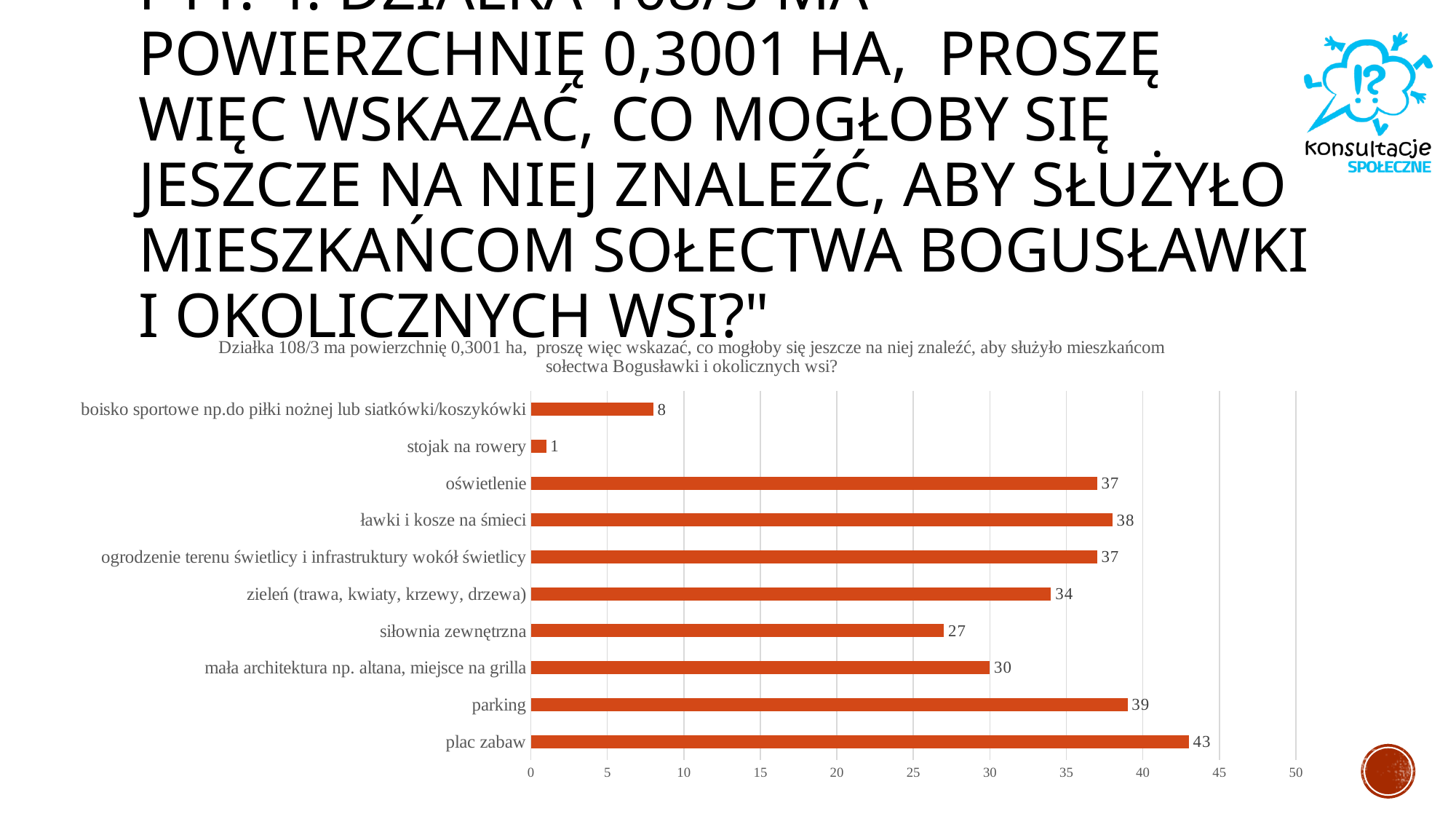
Which is larger, the value for "zieleń (trawa, kwiaty, krzewy, drzewa)" or the value for "siłownia zewnętrzna"? zieleń (trawa, kwiaty, krzewy, drzewa) Is the value for "ławki i kosze na śmieci" greater or less than 35? greater What is the value for "siłownia zewnętrzna"? 27 Which category has the lowest value? stojak na rowery How many categories are shown in the chart? 10 What is the value for "stojak na rowery"? 1 Which category has the highest value? plac zabaw What kind of chart is shown on the slide? bar chart What is the value for "boisko sportowe np.do piłki nożnej lub siatkówki/koszykówki"? 8 What is the difference between the values for "parking" and "mała architektura np. altana, miejsce na grilla"? 9 What is the highest value shown on the x axis? 50 What is the value for "plac zabaw"? 43